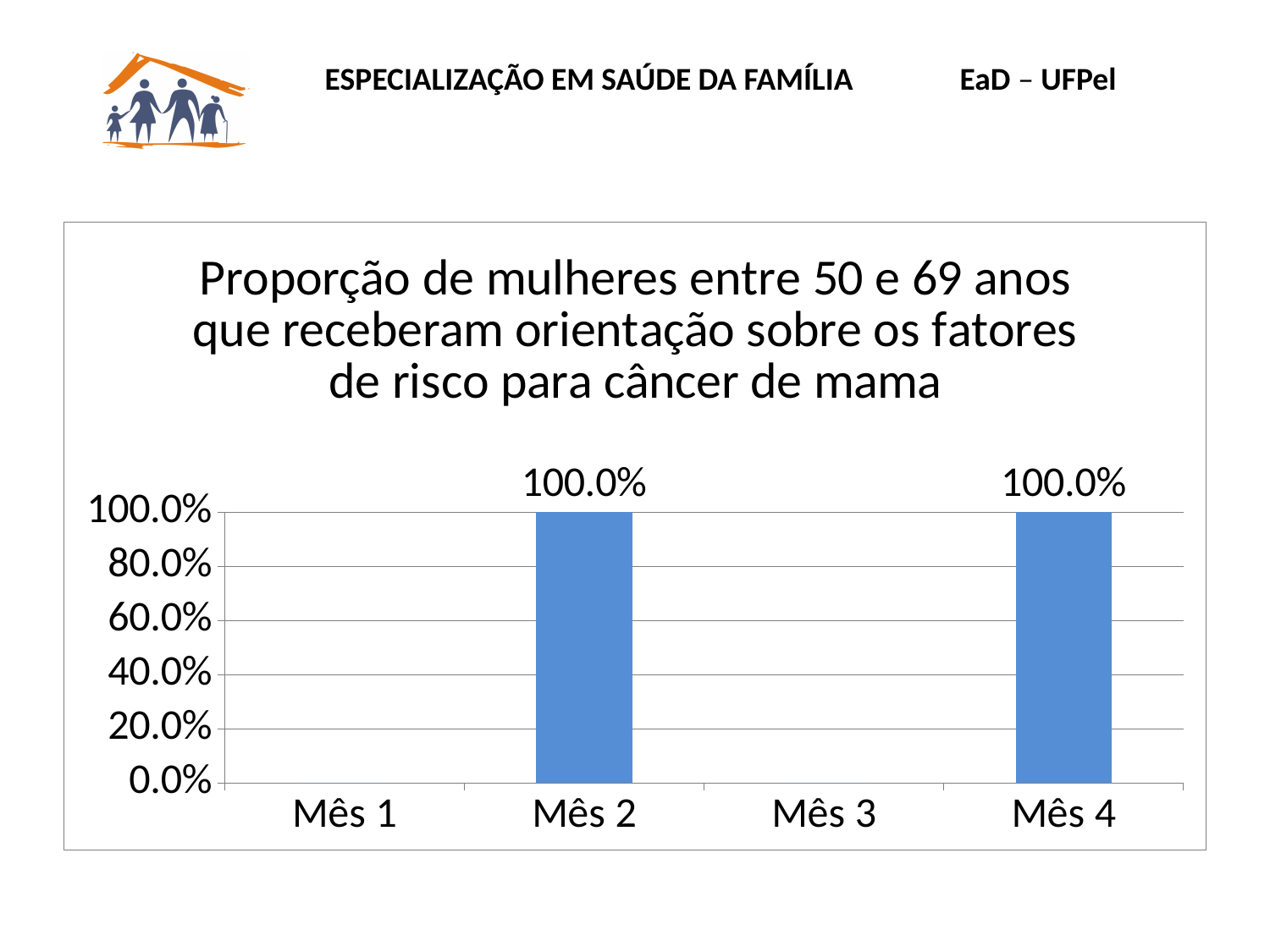
What is the highest value shown on the y axis? 100.0% What is the value for Mês 4? 100.0% What is the value for Mês 2? 100.0% What is the title of the chart? Proporção de mulheres entre 50 e 69 anos que receberam orientação sobre os fatores de risco para câncer de mama How many categories are shown on the x axis? 4 What kind of chart is shown on the slide? Bar chart Is the value for Mês 4 greater or less than 60.0%? greater Is the value for Mês 2 greater or less than 80.0%? greater Which categories have a visible bar in the chart? Mês 2 and Mês 4 What is the difference between the values for Mês 2 and Mês 4? 0.0%